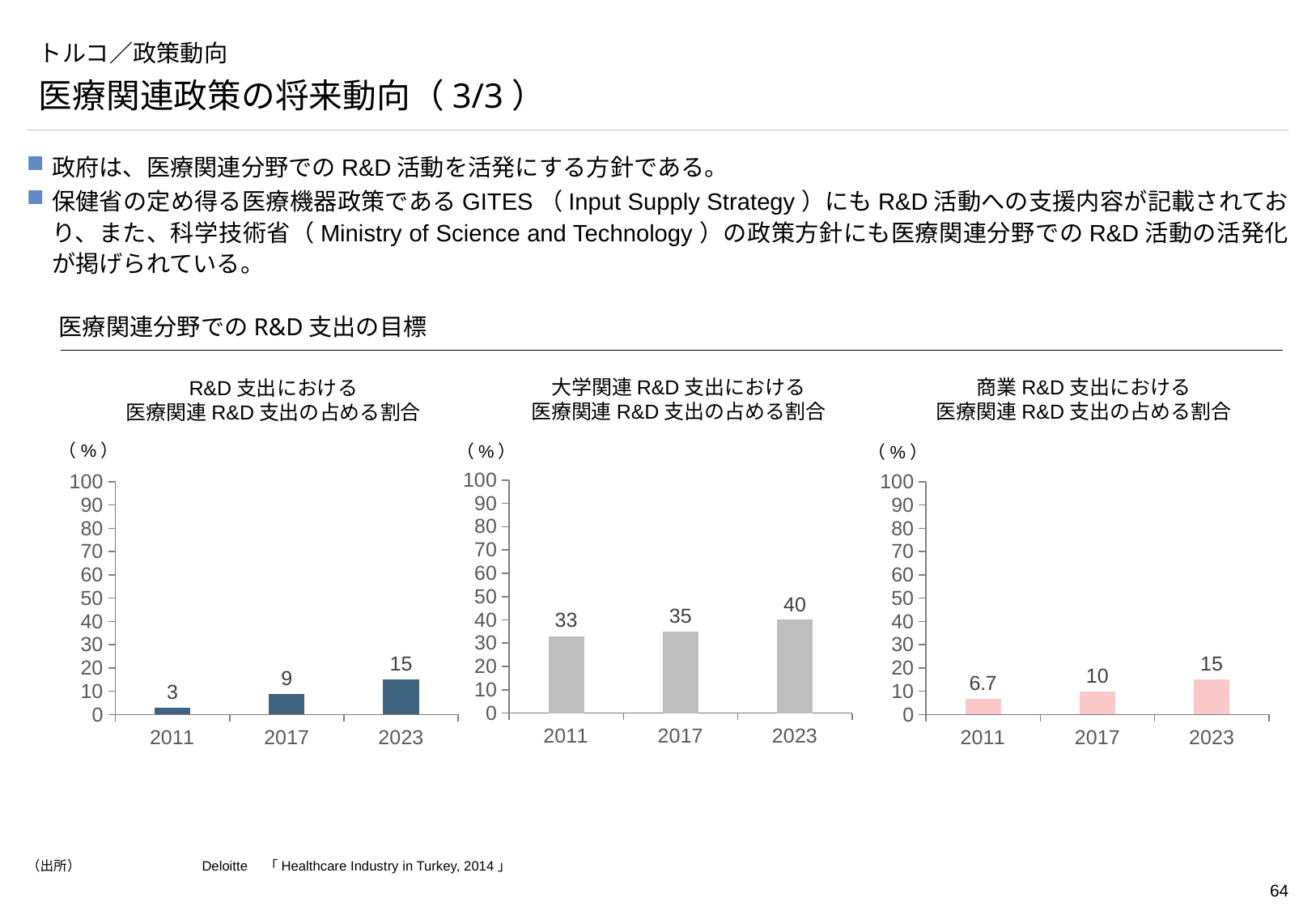
In the middle chart (大学関連R&D支出における医療関連R&D支出の占める割合), what is the value for 2011? 33 In the right chart (商業R&D支出における医療関連R&D支出の占める割合), what is the value for 2011? 6.7 Which is larger: the 2017 value in the left chart (R&D支出) or the 2017 value in the right chart (商業R&D支出)? The right chart (商業R&D支出), 10 In the middle chart (大学関連R&D支出), which year has the highest value? 2023 In the middle chart (大学関連R&D支出), what is the difference between the 2023 value and the 2011 value? 7 In the left chart (R&D支出における医療関連R&D支出の占める割合), which year has the lowest value? 2011 In the right chart (商業R&D支出), do the values rise or fall from 2011 to 2023? Rise What type of chart is the left chart (R&D支出における医療関連R&D支出の占める割合)? Bar chart How many years are plotted in the right chart (商業R&D支出)? 3 In the left chart (R&D支出における医療関連R&D支出の占める割合), what is the value for 2023? 15 In the right chart (商業R&D支出), what is the difference between the 2023 value and the 2017 value? 5 In the middle chart (大学関連R&D支出), is the value for 2017 greater or less than 30? greater